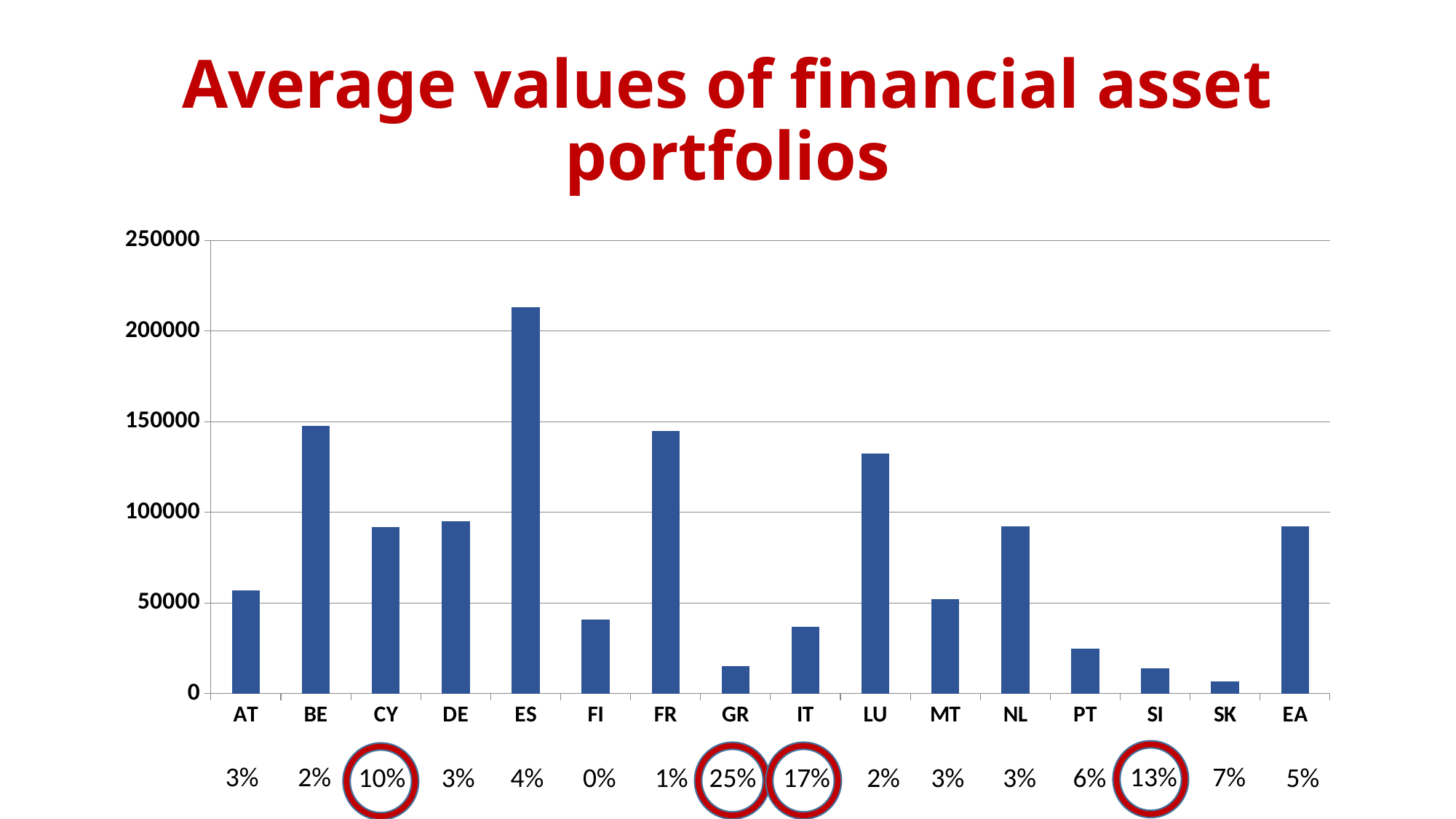
Which is larger, the value for IT or the value for MT? MT Which is larger, the value for FR or the value for LU? FR Is the value for LU greater or less than 100000? greater Which country has the highest average value of financial asset portfolios? ES What kind of chart is shown on the slide? bar chart Is the value for ES greater or less than 200000? greater Is the value for FI greater or less than 50000? less How many categories are shown on the x axis of the chart? 16 What is the title of the slide? Average values of financial asset portfolios Which country has the lowest average value of financial asset portfolios? SK